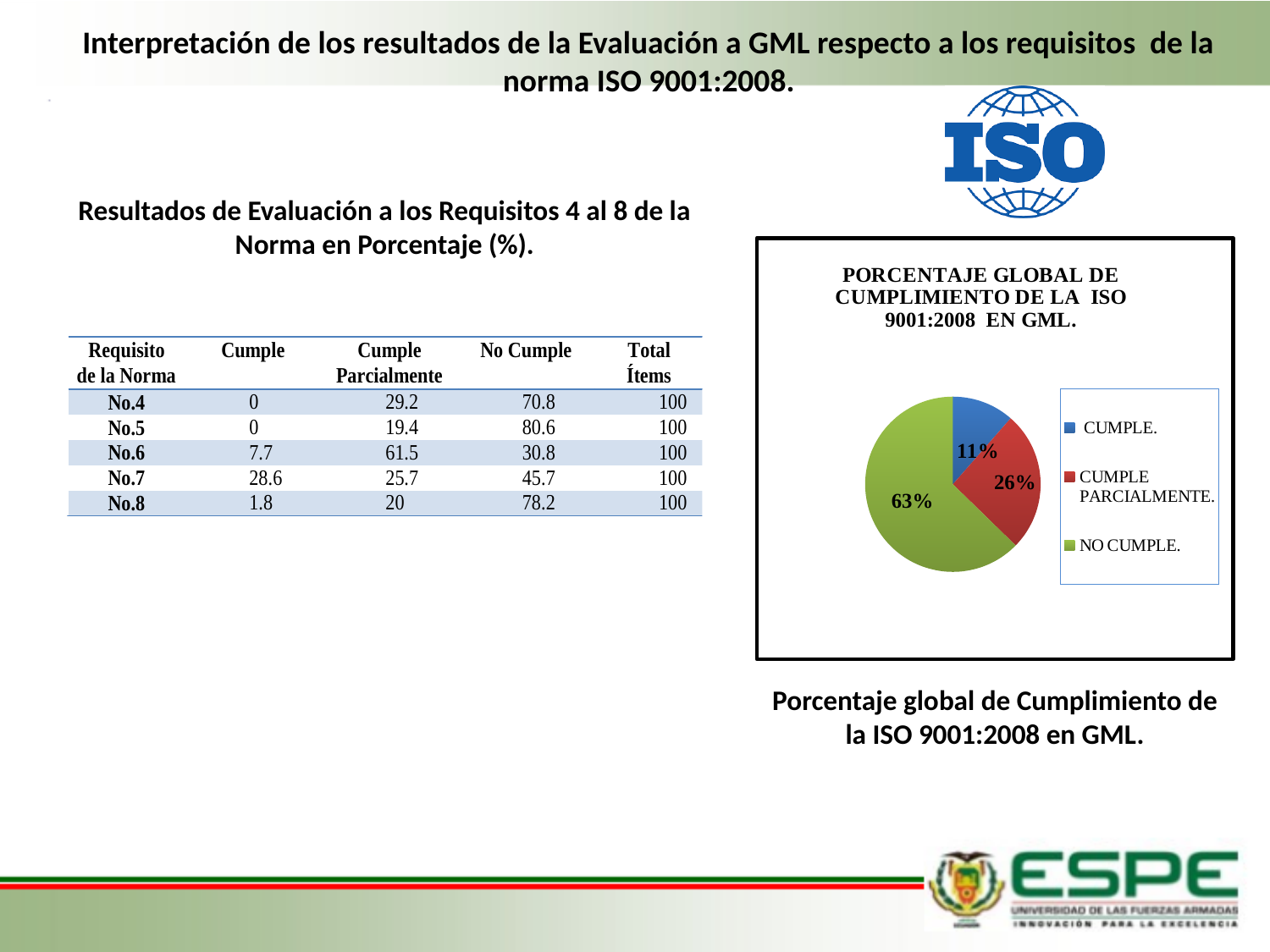
How many slices does the pie chart have? 3 What percentage of the pie chart corresponds to CUMPLE PARCIALMENTE? 26% What percentage of the pie chart corresponds to NO CUMPLE? 63% What percentage of the pie chart corresponds to CUMPLE? 11% What kind of chart is shown on the slide? Pie chart Which slice is larger in the pie chart, CUMPLE PARCIALMENTE or CUMPLE? CUMPLE PARCIALMENTE Which category has the largest slice in the pie chart? NO CUMPLE How many entries does the legend of the pie chart list? 3 What colour is the NO CUMPLE slice in the pie chart? Green What is the difference in percentage points between the NO CUMPLE slice and the CUMPLE slice? 52 What is the title of the pie chart? PORCENTAJE GLOBAL DE CUMPLIMIENTO DE LA ISO 9001:2008 EN GML. Which category has the smallest slice in the pie chart? CUMPLE